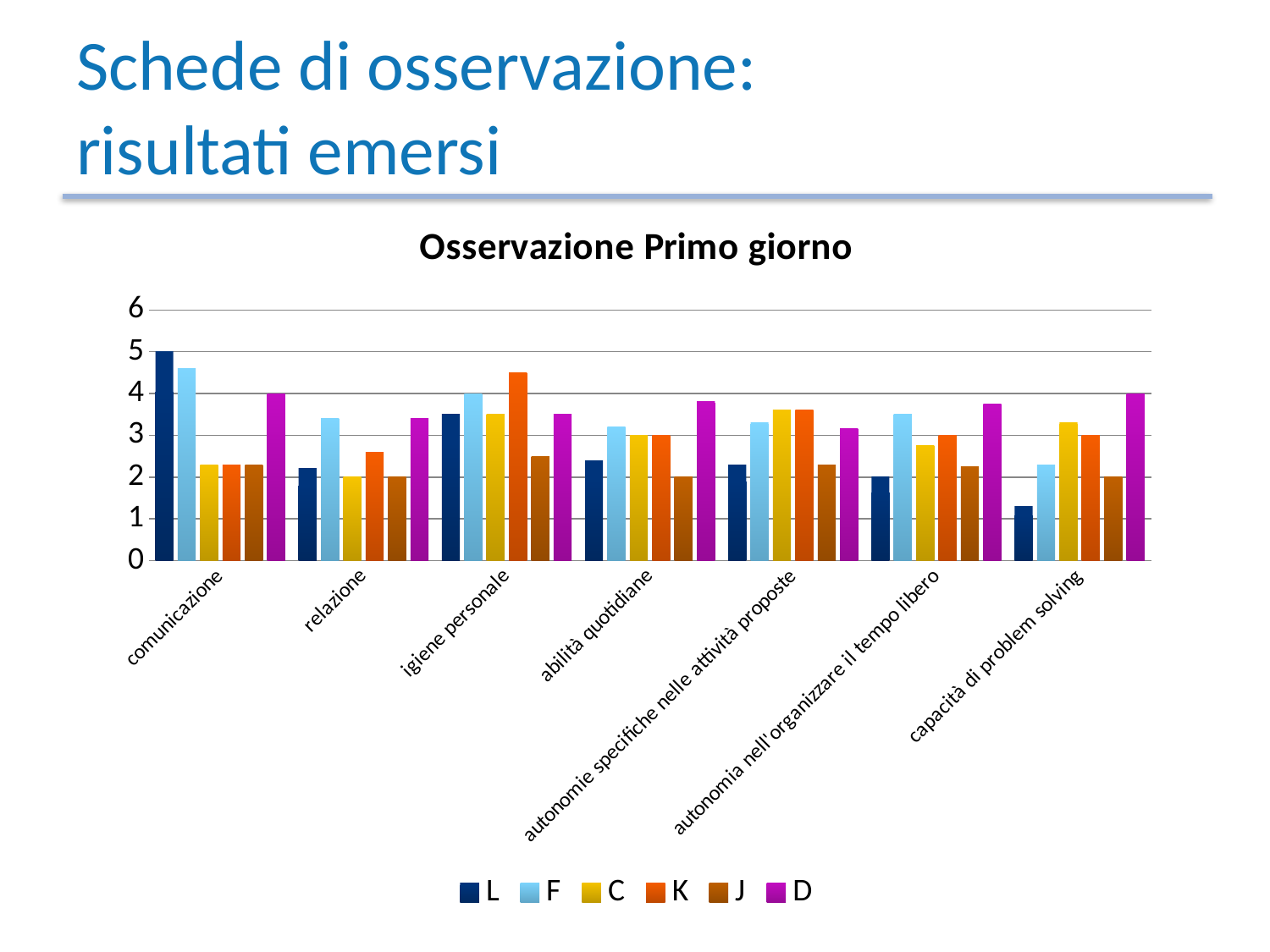
Is the value for K in the igiene personale category greater or less than 4? greater What is the value for D in the capacità di problem solving category? 4 What is the value for L in the comunicazione category? 5 How many series does the legend list? 6 Which is larger in the relazione category, the value for F or the value for L? F What is the title of the chart? Osservazione Primo giorno What kind of chart is shown on the slide? bar chart What is the value for L in the autonomia nell'organizzare il tempo libero category? 2 Which series has the highest value in the comunicazione category? L What is the value for F in the igiene personale category? 4 Which series has the lowest value in the capacità di problem solving category? L How many categories are shown on the x axis? 7